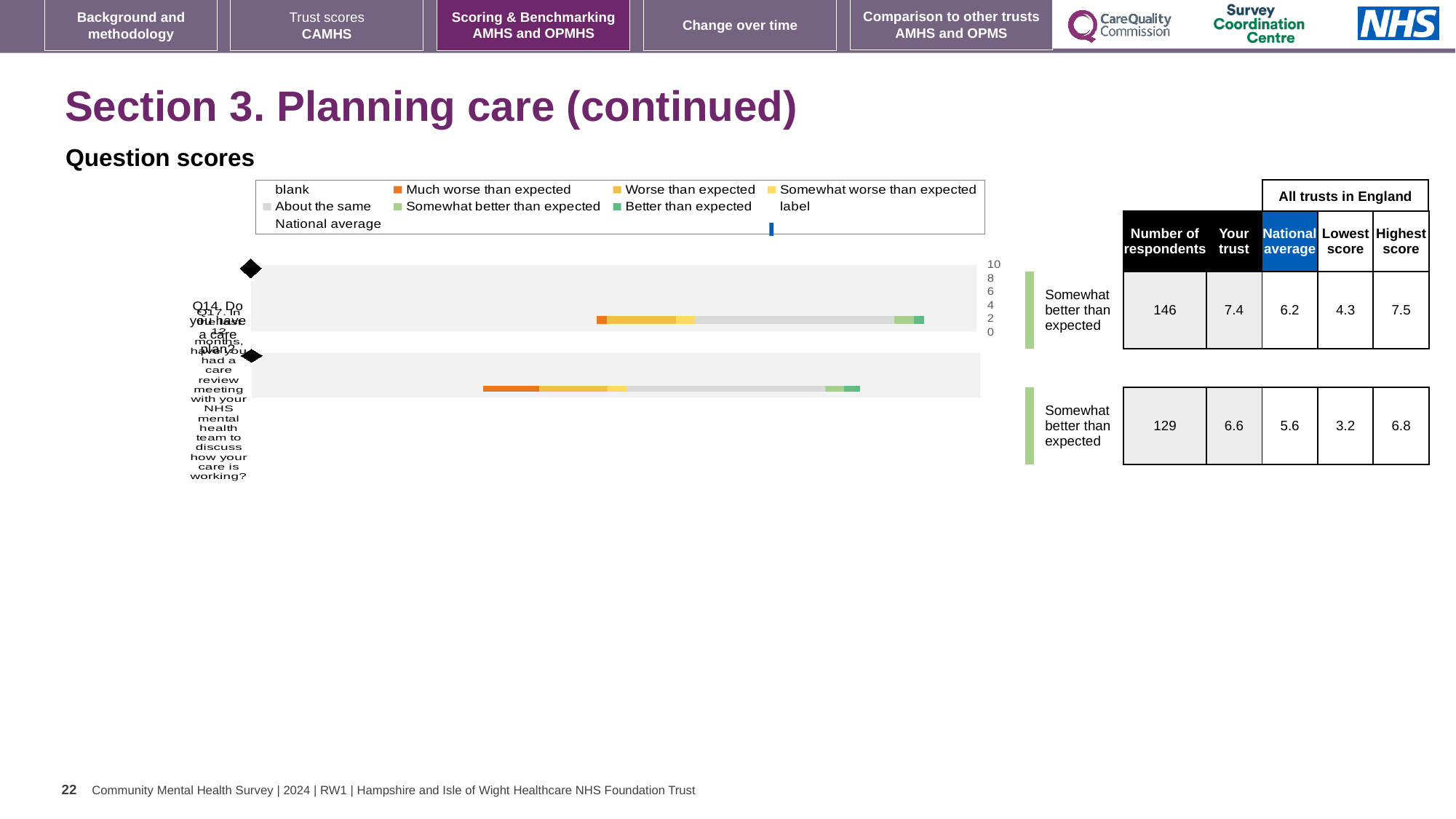
What is the difference between the 'Your trust' score and the national average for Q14? 1.2 How many questions (bars) are plotted in the question scores chart? 2 In the chart legend, which category is shown in orange? Much worse than expected What is the maximum value shown on the chart's score axis? 10 What is the 'Your trust' score for Q17 shown alongside the chart? 6.6 What is the 'Your trust' score for Q14 shown alongside the chart? 7.4 In the chart legend, what colour represents 'About the same'? grey What kind of chart is used to show the question scores on this slide? bar chart Which question has the higher 'Your trust' score, Q14 or Q17? Q14 What benchmark rating is shown next to the bar for Q17 (care review meeting)? Somewhat better than expected What benchmark rating is shown next to the bar for Q14 (Do you have a care plan?)? Somewhat better than expected How many respondents answered Q17 according to the table beside the chart? 129